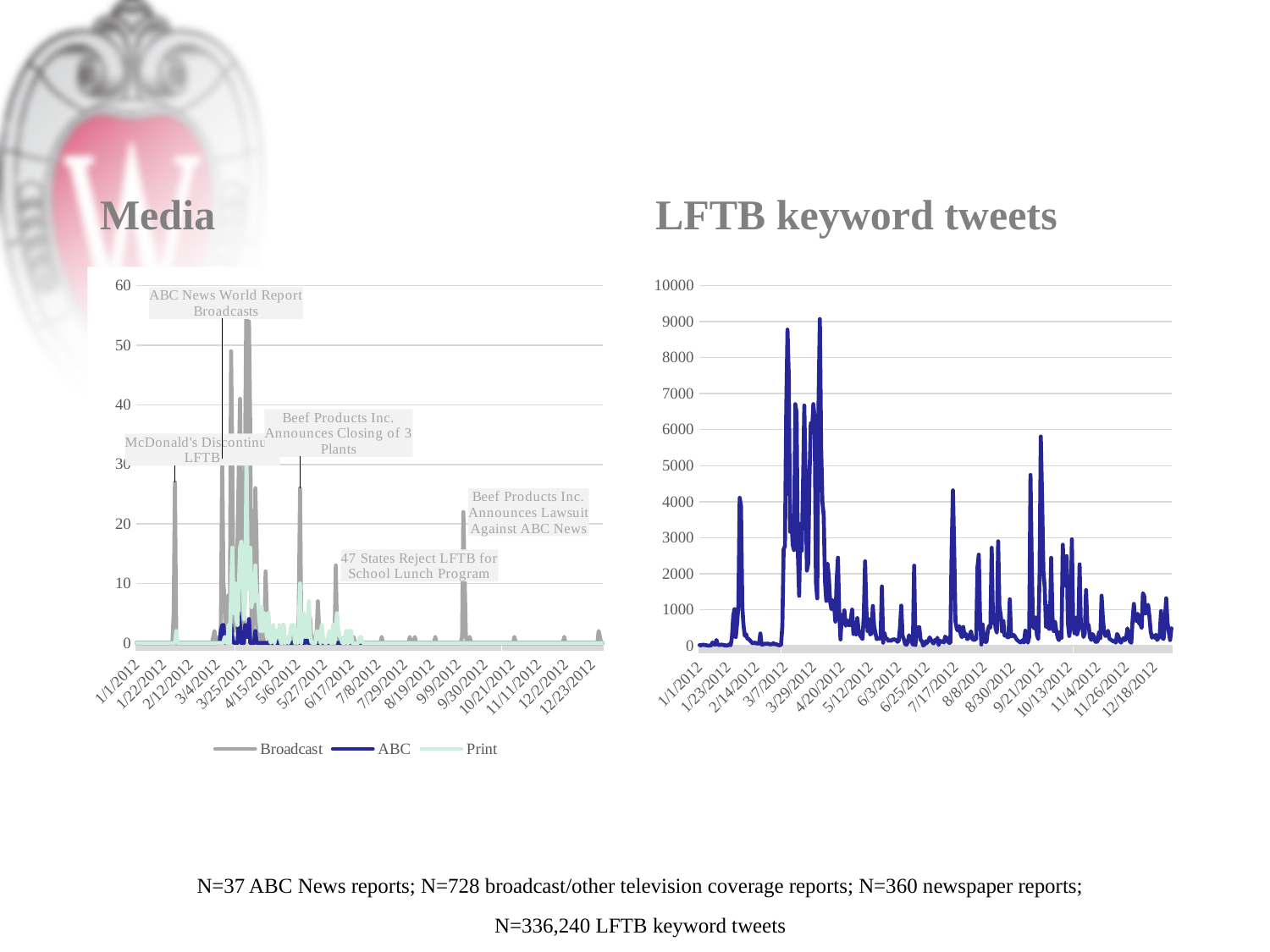
How many series does the legend of the "Media" chart list? 3 In the "Media" chart, which series has the lowest peak value? ABC What kind of chart is the "LFTB keyword tweets" chart on the right of the slide? line chart In the "Media" chart, is the highest value of the Print series greater or less than 20? greater In the "LFTB keyword tweets" chart, is the peak near 9/21/2012 greater or less than 7000? less In the "Media" chart, which series reaches the highest value? Broadcast In the "Media" chart, is the Broadcast peak larger than the Print peak? Yes In the "Media" chart, is the highest value of the ABC series greater or less than 10? less What kind of chart is the "Media" chart on the left of the slide? line chart What are the three legend entries of the "Media" chart? Broadcast, ABC, Print